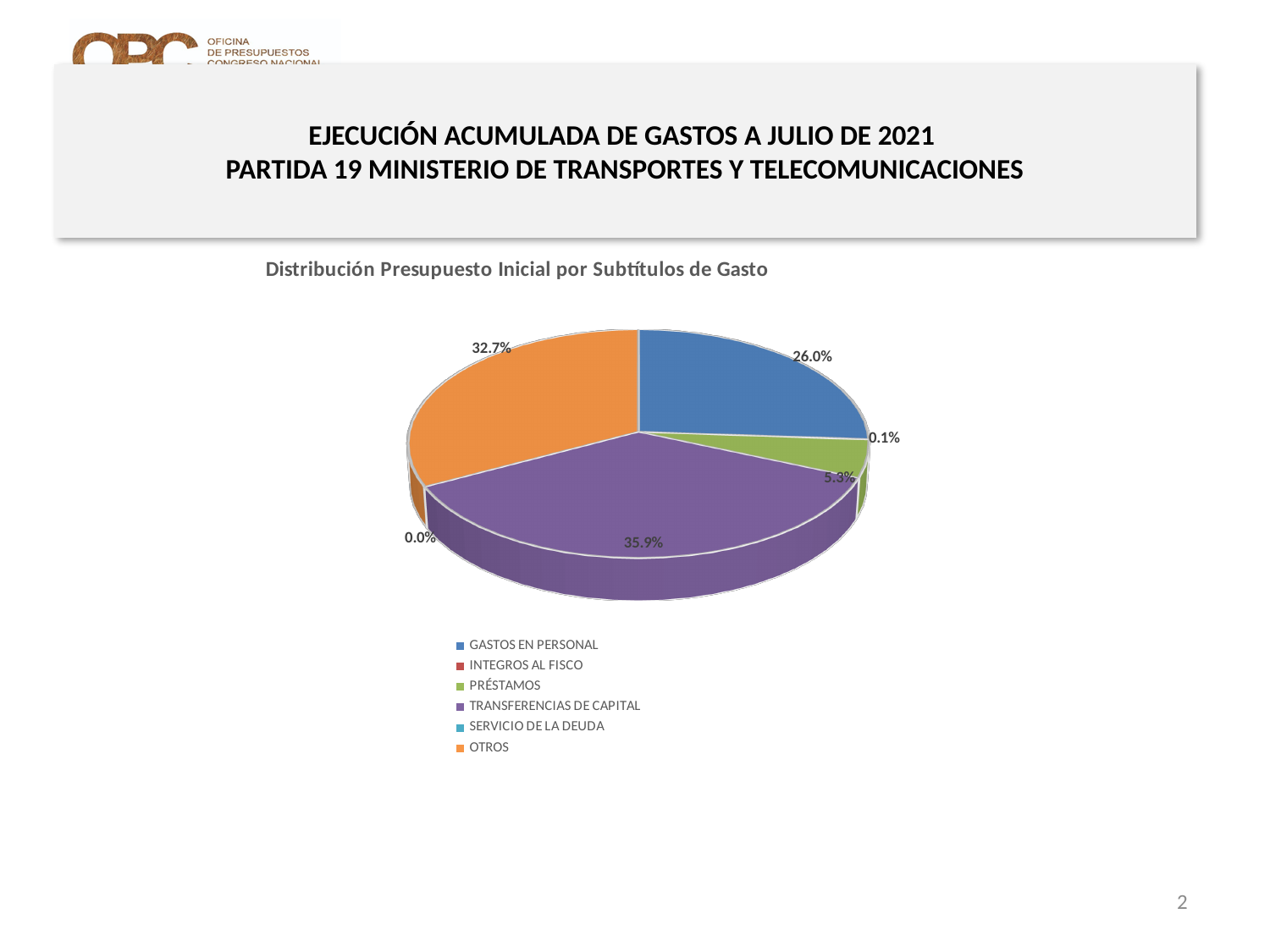
What share of the pie does OTROS represent? 32.7% Which is larger, the share of GASTOS EN PERSONAL or the share of PRÉSTAMOS? GASTOS EN PERSONAL Which category has the smallest share of the pie? SERVICIO DE LA DEUDA What is the title of the chart? Distribución Presupuesto Inicial por Subtítulos de Gasto What type of chart is shown on the slide? Pie chart What share of the pie does TRANSFERENCIAS DE CAPITAL represent? 35.9% What share of the pie does GASTOS EN PERSONAL represent? 26.0% What is the difference between the shares of TRANSFERENCIAS DE CAPITAL and OTROS? 3.2% How many categories does the legend list? 6 Which category has the largest share of the pie? TRANSFERENCIAS DE CAPITAL What colour is the slice for TRANSFERENCIAS DE CAPITAL? Purple What share of the pie does PRÉSTAMOS represent? 5.3%